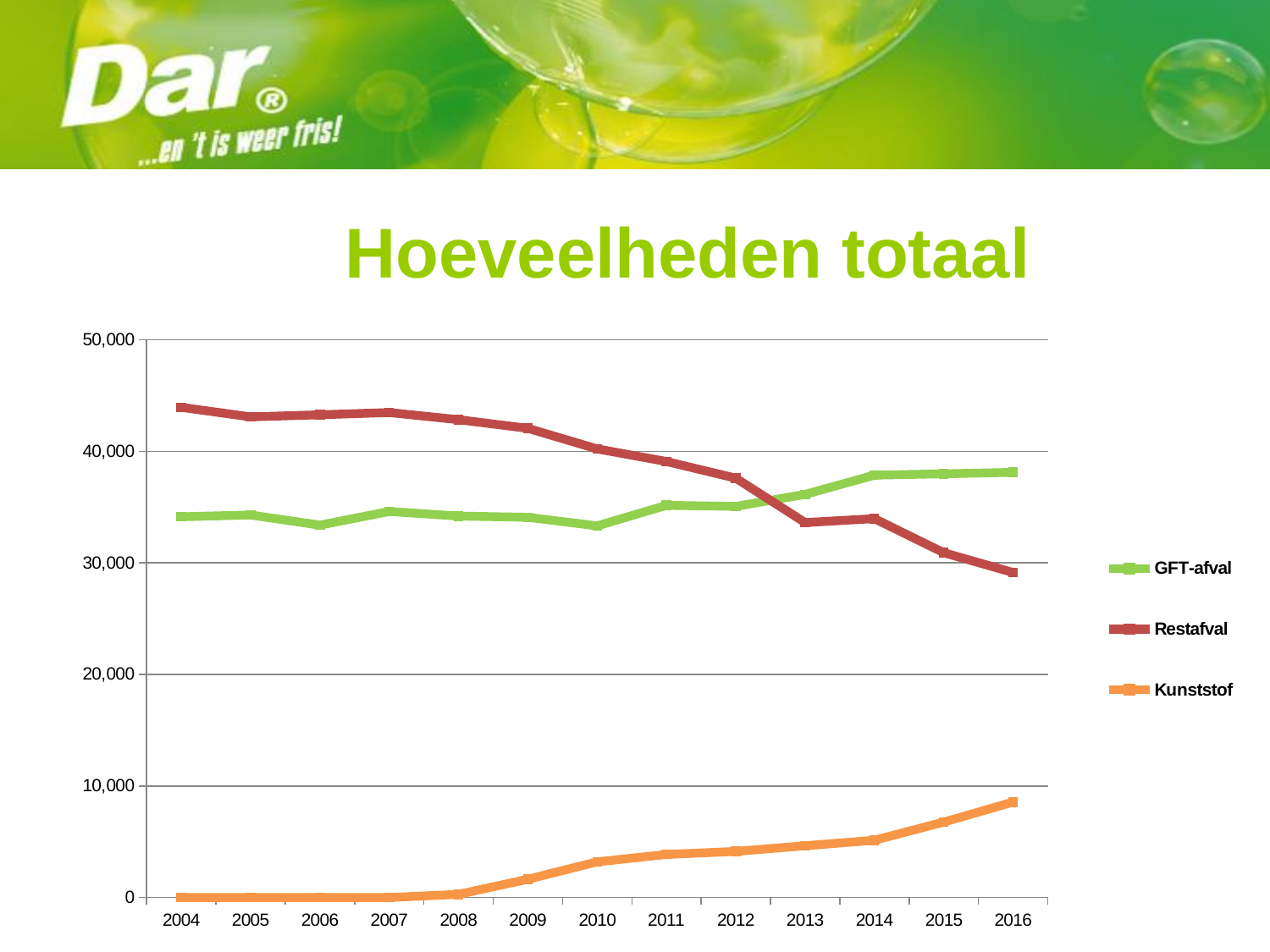
What is the title of the chart? Hoeveelheden totaal What kind of chart is shown on the slide? line chart Which series is drawn in orange? Kunststof Does the Restafval line rise or fall from 2004 to 2016? fall How many series does the legend list? 3 How many years are shown along the x axis? 13 In 2016, which is larger: GFT-afval or Restafval? GFT-afval Does the Kunststof line rise or fall from 2008 to 2016? rise Which series has the lowest value in 2016? Kunststof Is the value for Kunststof in 2016 greater or less than 10,000? less Is the value for Restafval in 2004 greater or less than 40,000? greater Which series has the highest value in 2004? Restafval